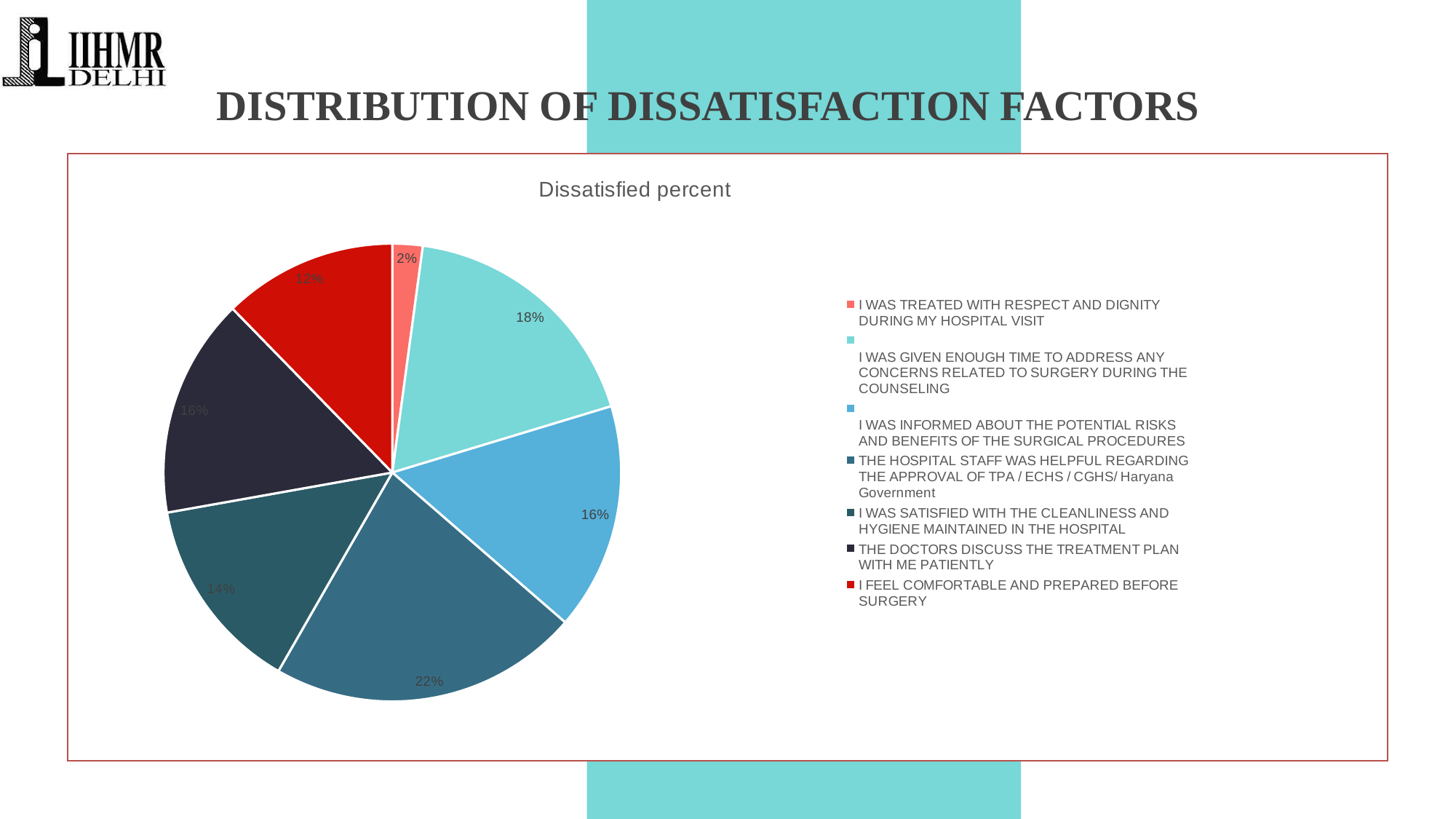
How many entries does the legend list? 7 What percentage is shown for 'I FEEL COMFORTABLE AND PREPARED BEFORE SURGERY'? 12% What percentage is shown for 'THE HOSPITAL STAFF WAS HELPFUL REGARDING THE APPROVAL OF TPA / ECHS / CGHS/ Haryana Government'? 22% What type of chart is shown on the slide? pie chart How many slices does the pie chart have? 7 What is the difference in percentage points between the 'I WAS GIVEN ENOUGH TIME TO ADDRESS ANY CONCERNS RELATED TO SURGERY DURING THE COUNSELING' slice and the 'I FEEL COMFORTABLE AND PREPARED BEFORE SURGERY' slice? 6 What is the title of the chart? Dissatisfied percent Which factor has the smallest share of the pie? I WAS TREATED WITH RESPECT AND DIGNITY DURING MY HOSPITAL VISIT What percentage is shown for 'I WAS TREATED WITH RESPECT AND DIGNITY DURING MY HOSPITAL VISIT'? 2% What percentage is shown for 'I WAS SATISFIED WITH THE CLEANLINESS AND HYGIENE MAINTAINED IN THE HOSPITAL'? 14% Which is larger: the share for 'I WAS INFORMED ABOUT THE POTENTIAL RISKS AND BENEFITS OF THE SURGICAL PROCEDURES' or the share for 'I WAS SATISFIED WITH THE CLEANLINESS AND HYGIENE MAINTAINED IN THE HOSPITAL'? I WAS INFORMED ABOUT THE POTENTIAL RISKS AND BENEFITS OF THE SURGICAL PROCEDURES Which factor has the largest share of the pie? THE HOSPITAL STAFF WAS HELPFUL REGARDING THE APPROVAL OF TPA / ECHS / CGHS/ Haryana Government